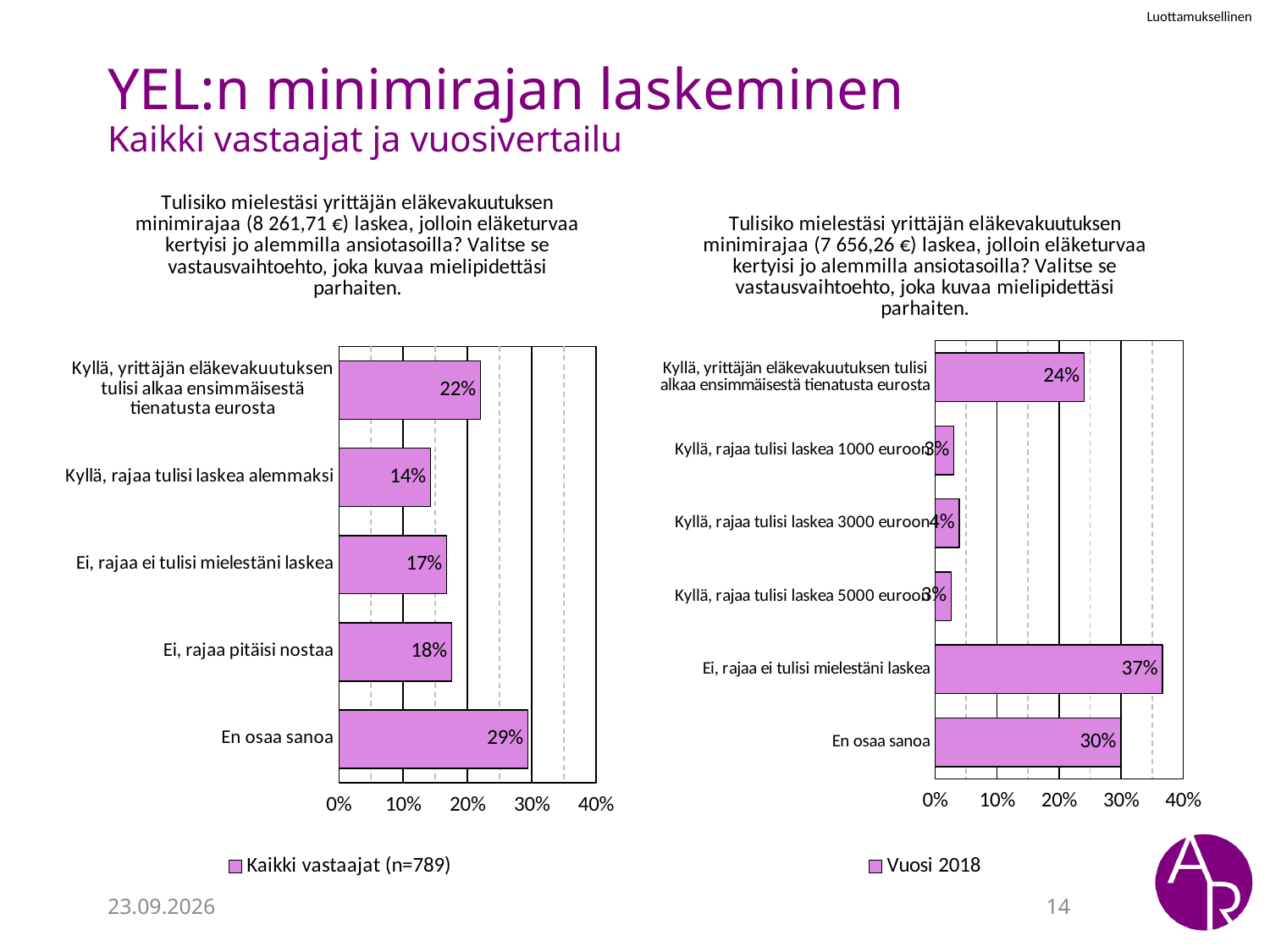
What is the legend entry of the right chart? Vuosi 2018 In the right chart, which category has the highest value? Ei, rajaa ei tulisi mielestäni laskea In the left chart, which category has the lowest value? Kyllä, rajaa tulisi laskea alemmaksi In the left chart, how many categories are shown? 5 In the right chart, which is larger: "En osaa sanoa" or "Kyllä, yrittäjän eläkevakuutuksen tulisi alkaa ensimmäisestä tienatusta eurosta"? En osaa sanoa In the left chart, what is the value for "Kyllä, rajaa tulisi laskea alemmaksi"? 14% In the right chart, what is the value for "Kyllä, rajaa tulisi laskea 3000 euroon"? 4% In the left chart, what is the value for "En osaa sanoa"? 29% In the right chart, what is the value for "Ei, rajaa ei tulisi mielestäni laskea"? 37% What type of chart is the left chart? Bar chart In the right chart, how many categories are shown? 6 In the left chart, what is the difference between "En osaa sanoa" and "Ei, rajaa pitäisi nostaa"? 11 percentage points